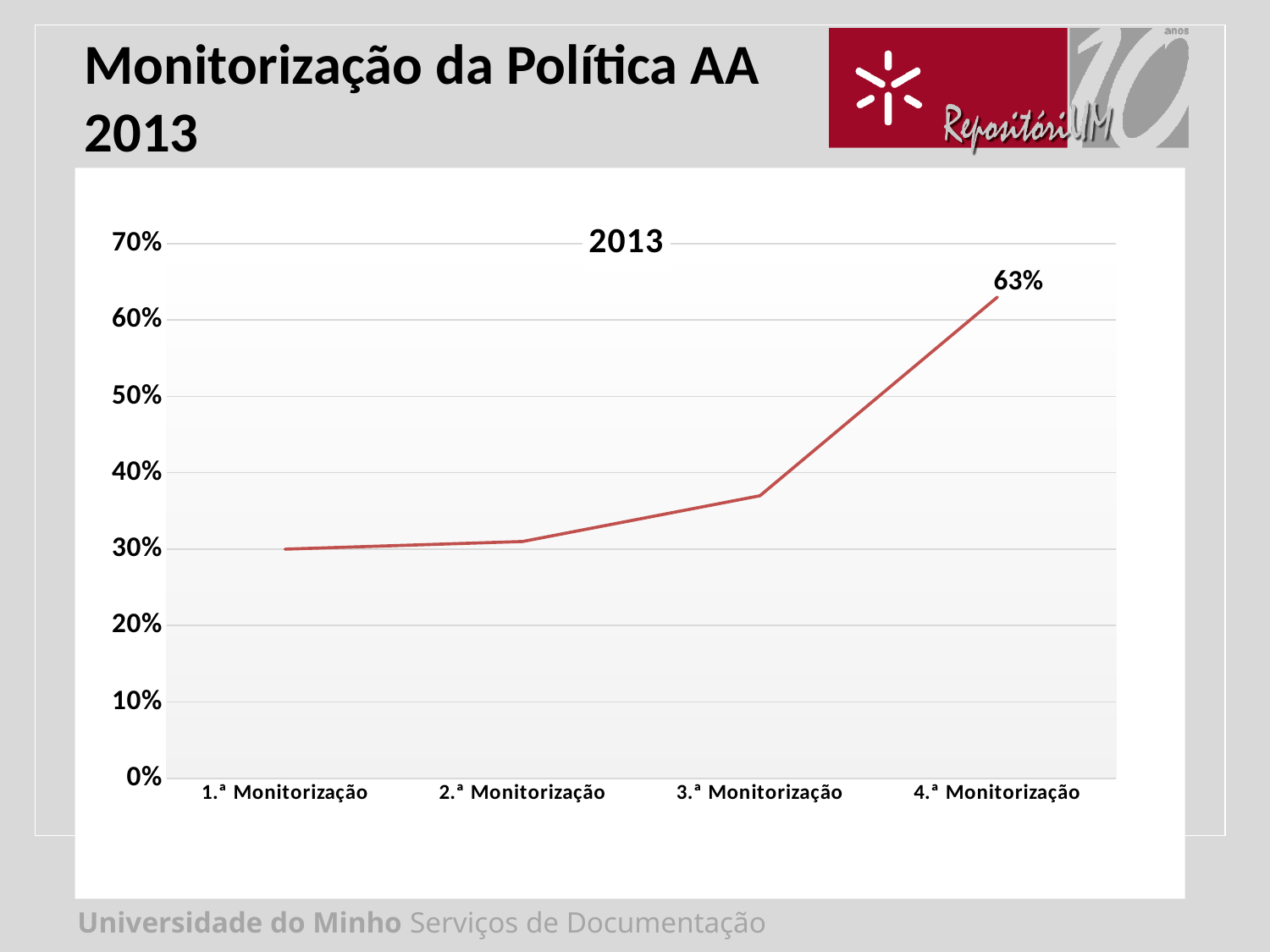
What is the value for 4.ª Monitorização? 63% Which monitorização has the highest value? 4.ª Monitorização Is the value for 4.ª Monitorização greater or less than 60%? greater Is the value for 3.ª Monitorização greater or less than 40%? less Which is larger, the value for 1.ª Monitorização or 3.ª Monitorização? 3.ª Monitorização What is the title of the chart? 2013 Do the values rise or fall from 1.ª Monitorização to 4.ª Monitorização? Rise Is the value for 3.ª Monitorização greater or less than 30%? greater What kind of chart is shown on the slide? Line chart Which is larger, the value for 3.ª Monitorização or 4.ª Monitorização? 4.ª Monitorização How many monitorizações are plotted on the x axis? 4